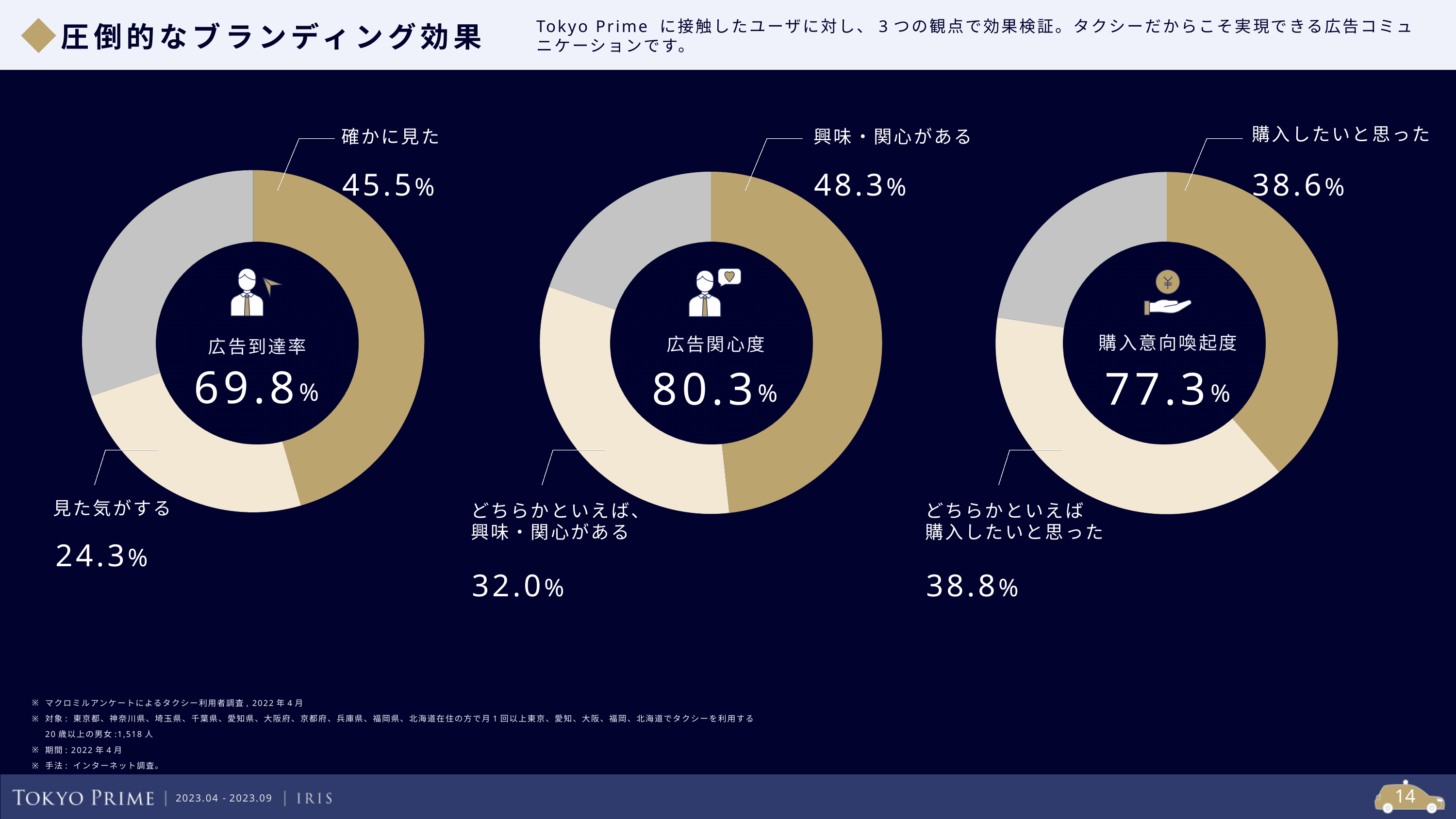
What is the overall 購入意向喚起度 value shown in the centre of the right chart? 77.3% In the left chart (広告到達率), what percentage of respondents answered 見た気がする? 24.3% In the right chart (購入意向喚起度), what is the difference between どちらかといえば購入したいと思った and 購入したいと思った? 0.2% What is the overall 広告到達率 value shown in the centre of the left chart? 69.8% In the middle chart (広告関心度), what is the difference between 興味・関心がある and どちらかといえば、興味・関心がある? 16.3% In the left chart (広告到達率), which is larger: 確かに見た or 見た気がする? 確かに見た In the left chart (広告到達率), what percentage of respondents answered 確かに見た? 45.5% How many donut charts are shown on the slide? 3 What kind of chart is used for the three metrics on this slide? Donut (pie) chart In the middle chart (広告関心度), what percentage answered 興味・関心がある? 48.3% In the middle chart (広告関心度), what percentage answered どちらかといえば、興味・関心がある? 32.0% In the right chart (購入意向喚起度), what percentage answered どちらかといえば購入したいと思った? 38.8%